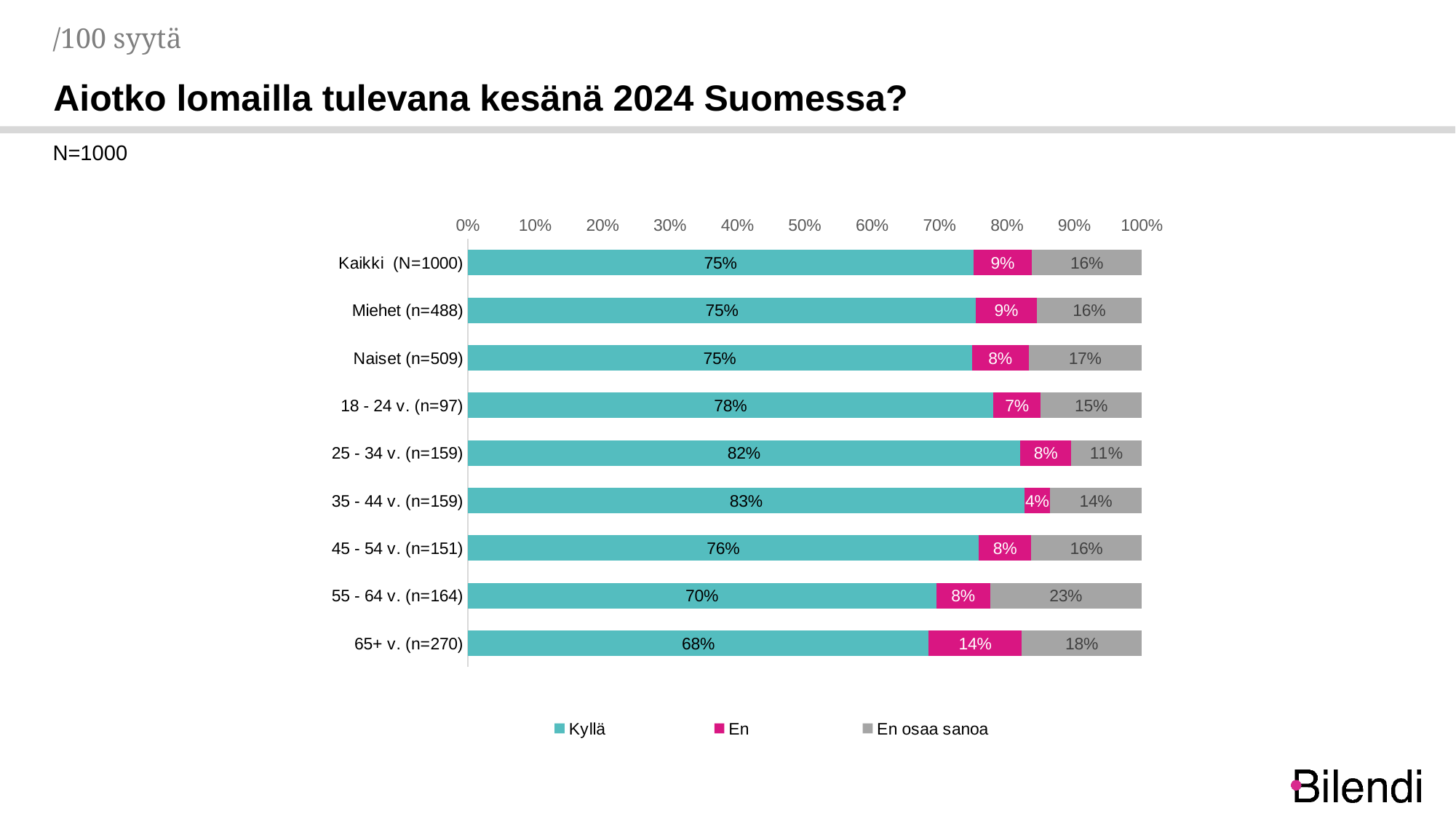
What is the En value for 65+ v. (n=270)? 14% What is the En osaa sanoa value for 55 - 64 v. (n=164)? 23% What kind of chart is shown on the slide? Stacked bar chart What is the title of the chart? Aiotko lomailla tulevana kesänä 2024 Suomessa? What is the difference between the Kyllä values for 25 - 34 v. (n=159) and 55 - 64 v. (n=164)? 12% Which category has the lowest Kyllä value? 65+ v. (n=270) What is the Kyllä value for 35 - 44 v. (n=159)? 83% How many categories are shown on the chart? 9 How many series does the legend list? 3 Which has a larger En osaa sanoa value, 18 - 24 v. (n=97) or 65+ v. (n=270)? 65+ v. (n=270) Which category has the highest En value? 65+ v. (n=270) Which category has the highest Kyllä value? 35 - 44 v. (n=159)